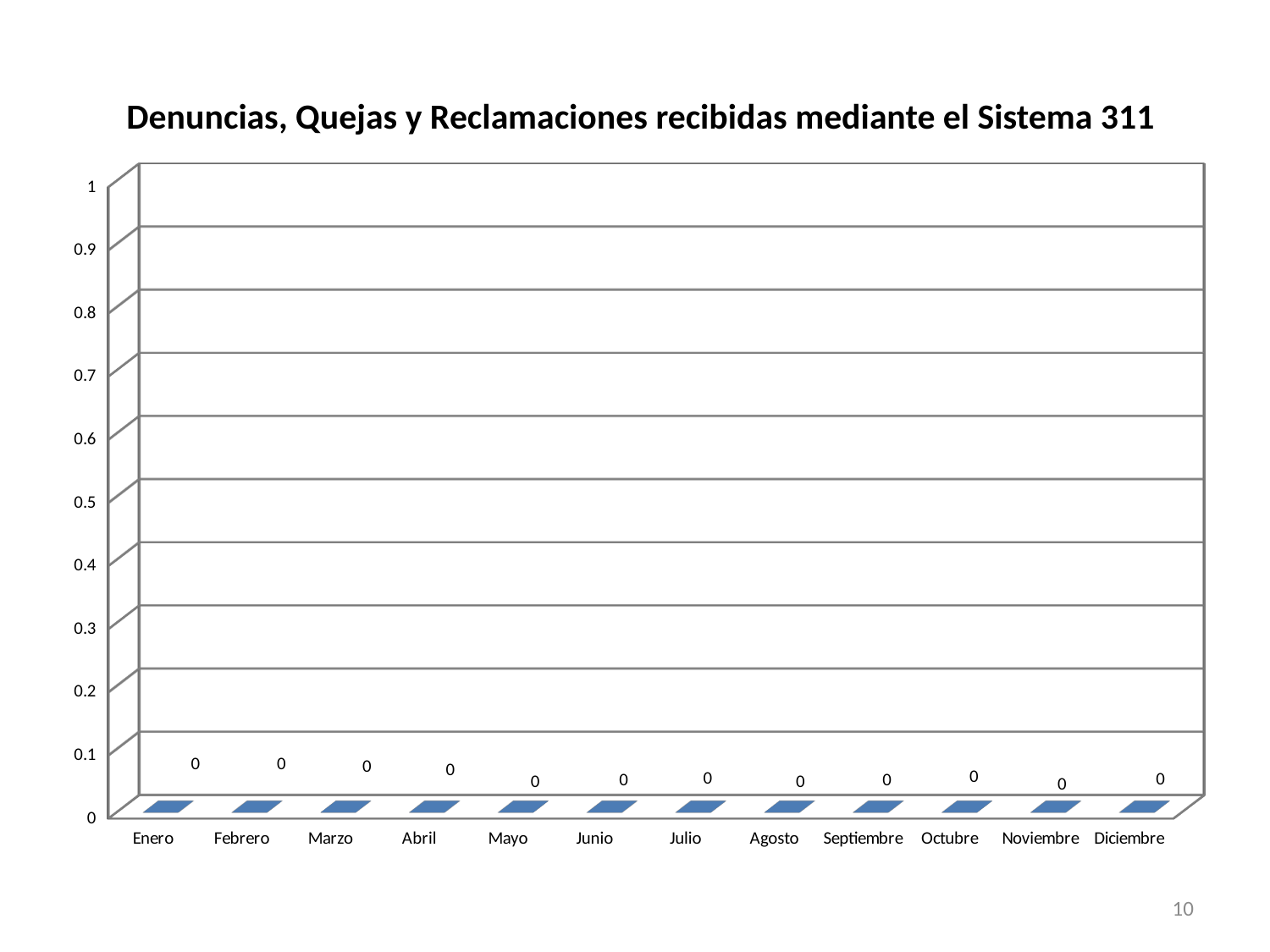
What is the value for Diciembre? 0 How many categories (months) are shown on the x axis? 12 What is the title of the chart? Denuncias, Quejas y Reclamaciones recibidas mediante el Sistema 311 What is the value for Julio? 0 What kind of chart is shown on the slide? Bar chart Is the value for Marzo greater or less than 0.5? less Do the values rise, fall, or stay the same from Enero to Diciembre? Stay the same What is the highest value shown on the y axis? 1 What is the difference between the values for Enero and Diciembre? 0 What is the value for Septiembre? 0 What is the value for Enero? 0